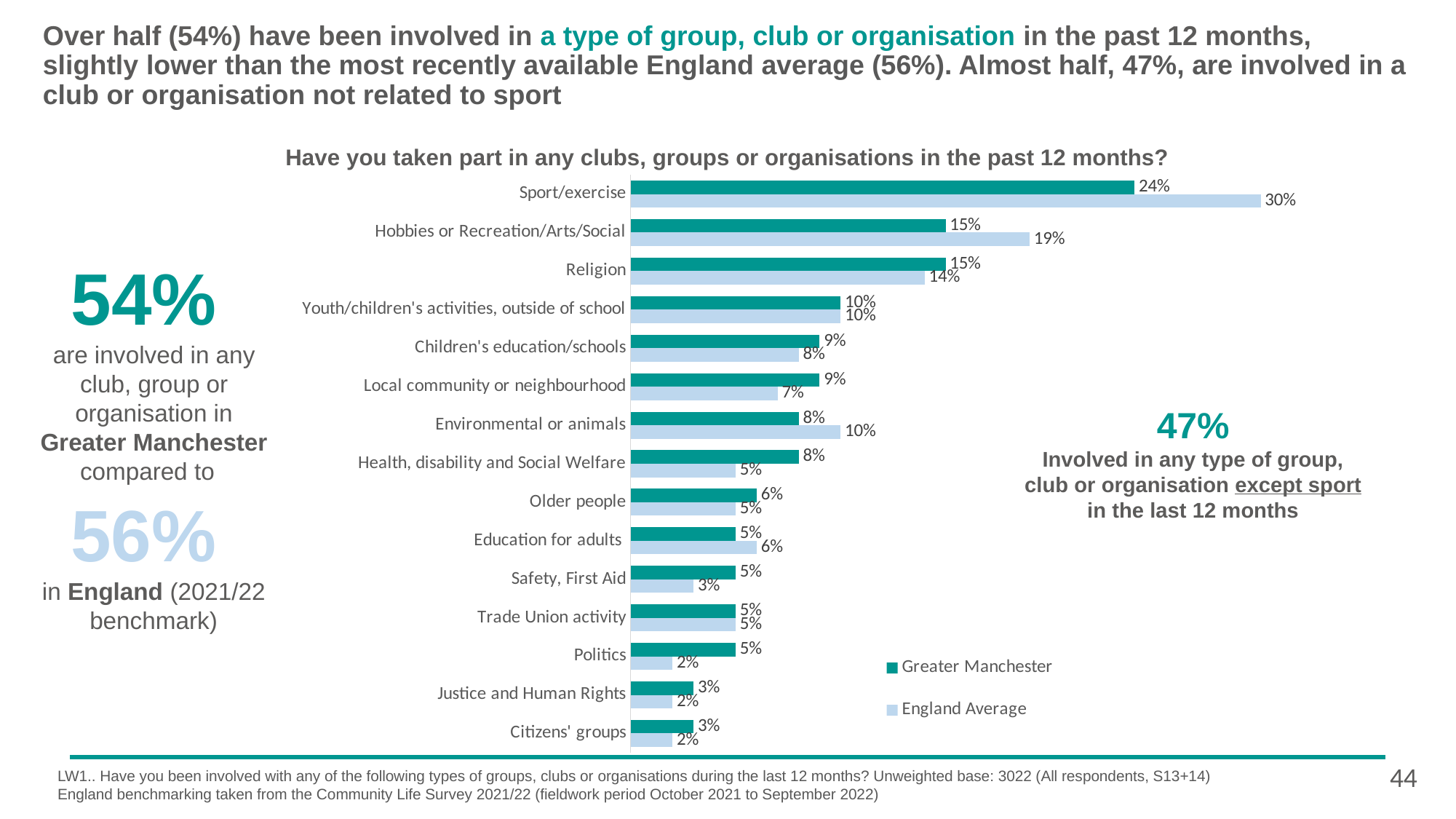
What is the difference between the England Average and Greater Manchester values for Sport/exercise? 6% Which category has the highest Greater Manchester value? Sport/exercise How many categories are shown in the chart? 15 What is the title of the chart? Have you taken part in any clubs, groups or organisations in the past 12 months? How many series does the legend list? 2 What is the England Average value for Politics? 2% What kind of chart is shown on the slide? Bar chart Which is larger for Environmental or animals: Greater Manchester or England Average? England Average What is the Greater Manchester value for Sport/exercise? 24% Which is larger for Health, disability and Social Welfare: Greater Manchester or England Average? Greater Manchester What is the England Average value for Hobbies or Recreation/Arts/Social? 19% What is the Greater Manchester value for Religion? 15%